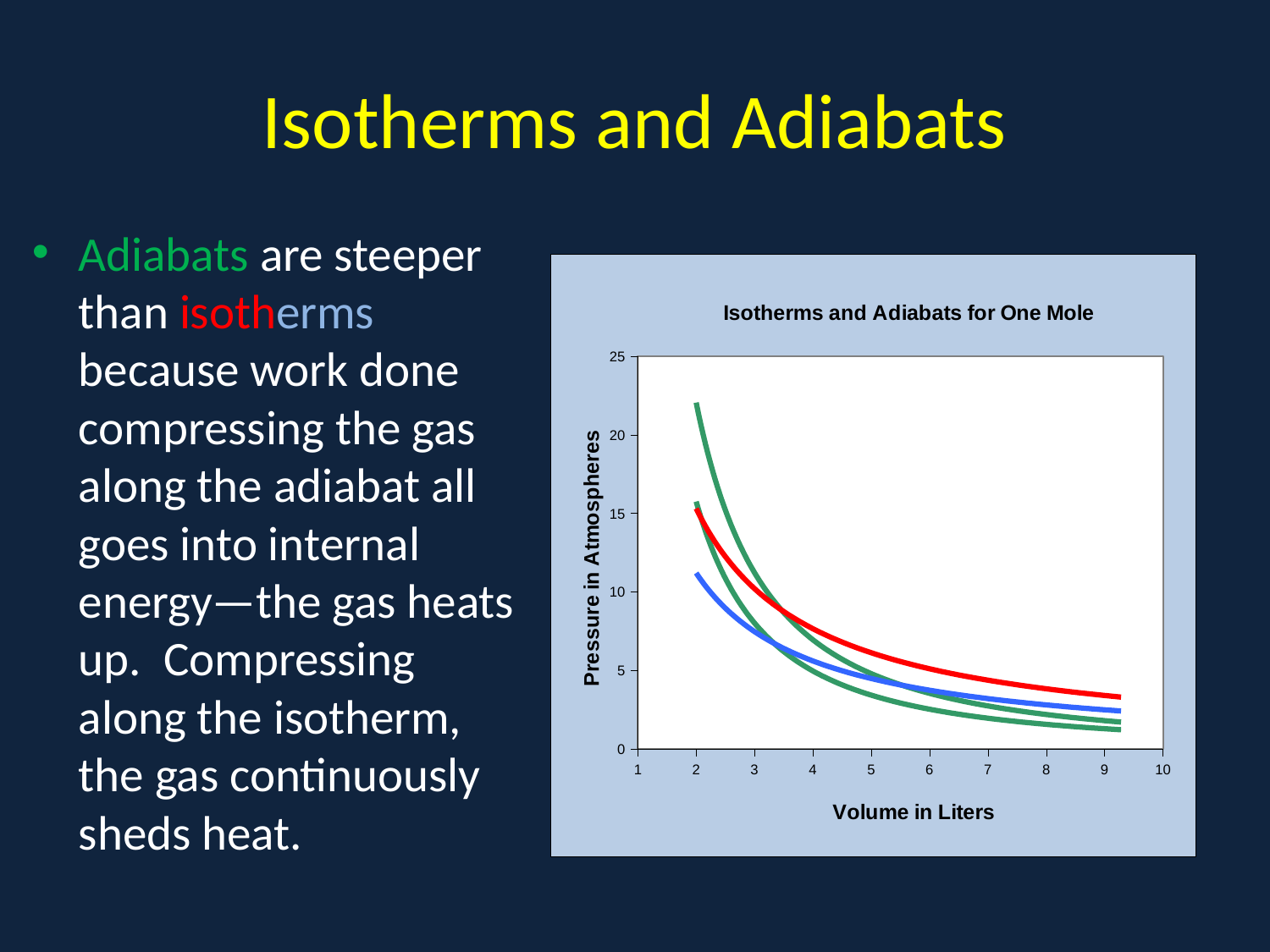
What kind of chart is shown on the slide? line chart At a volume of 9 liters, which curve has the higher pressure, the red curve or the blue curve? red curve At a volume of 2 liters, which curve has the lowest pressure? blue curve What is the title of the chart? Isotherms and Adiabats for One Mole What is the highest value shown on the vertical axis of the chart? 25 Is the pressure of the red curve at a volume of 4 liters greater or less than 5 atmospheres? greater Do the curves on the chart rise or fall as volume increases along the x axis? fall How many curves are plotted on the chart? 4 Is the pressure of the red curve at a volume of 9 liters greater or less than 5 atmospheres? less Is the pressure of the blue curve at a volume of 2 liters greater or less than 10 atmospheres? greater What is the label of the vertical axis of the chart? Pressure in Atmospheres